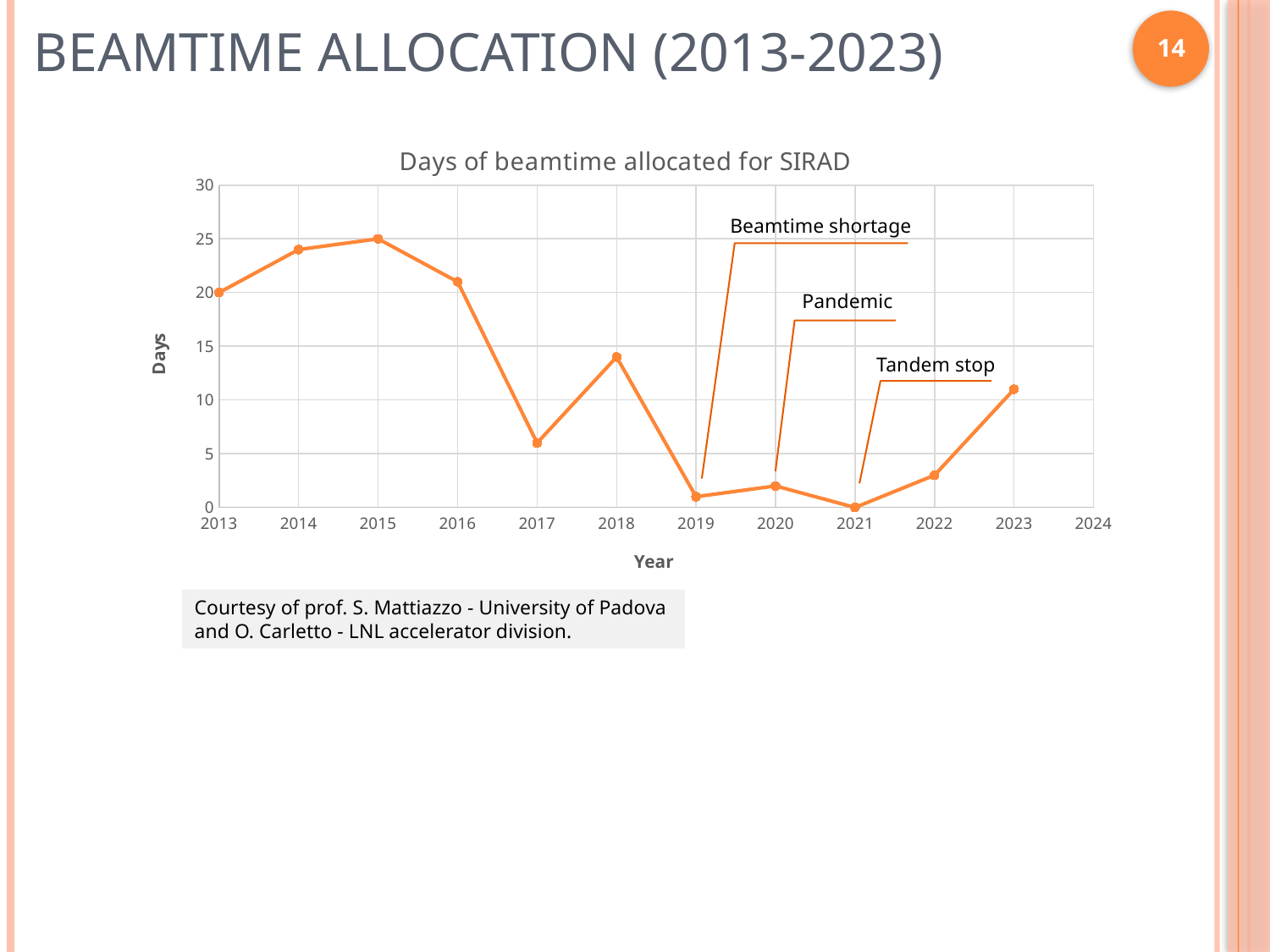
Is the value for 2017 greater or less than 10? less Which year has the lowest number of beamtime days? 2021 Which year has the larger value, 2016 or 2017? 2016 What is the title of the chart? Days of beamtime allocated for SIRAD Is the value for 2023 greater or less than 15? less What kind of chart is shown on the slide? line chart Do the values rise or fall from 2021 to 2023? rise How many days of beamtime were allocated in 2015? 25 How many years are plotted on the chart? 11 How many days of beamtime were allocated in 2021? 0 Is the value for 2018 greater or less than 10? greater How many days of beamtime were allocated in 2013? 20